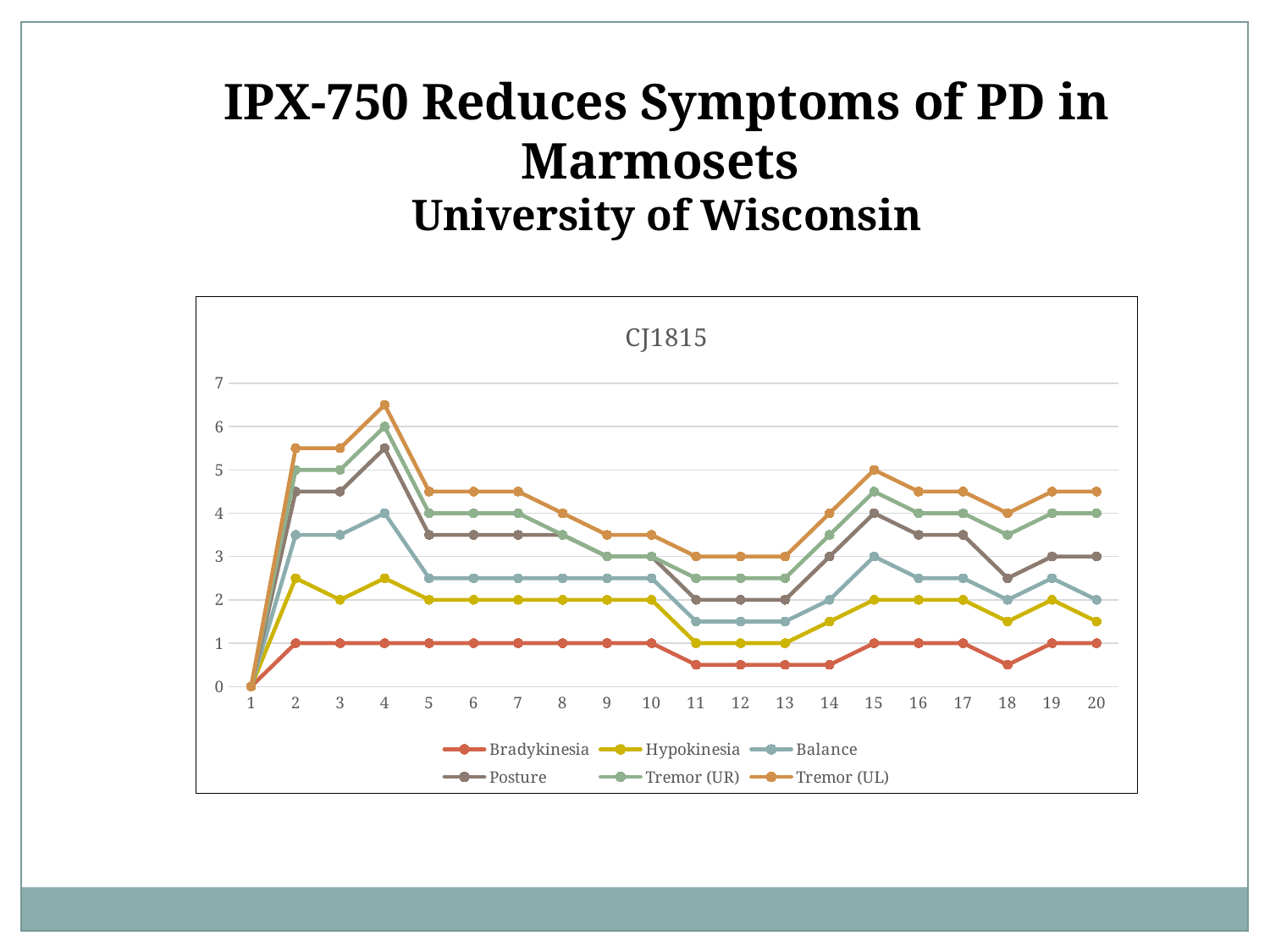
How many series does the legend list? 6 What is the title of the chart? CJ1815 Does the Tremor (UL) line rise or fall from point 4 to point 5? fall What kind of chart is shown on the slide? line chart What is the value of all series at point 1? 0 How many points are there along the x axis? 20 What is the value of Bradykinesia at point 2? 1